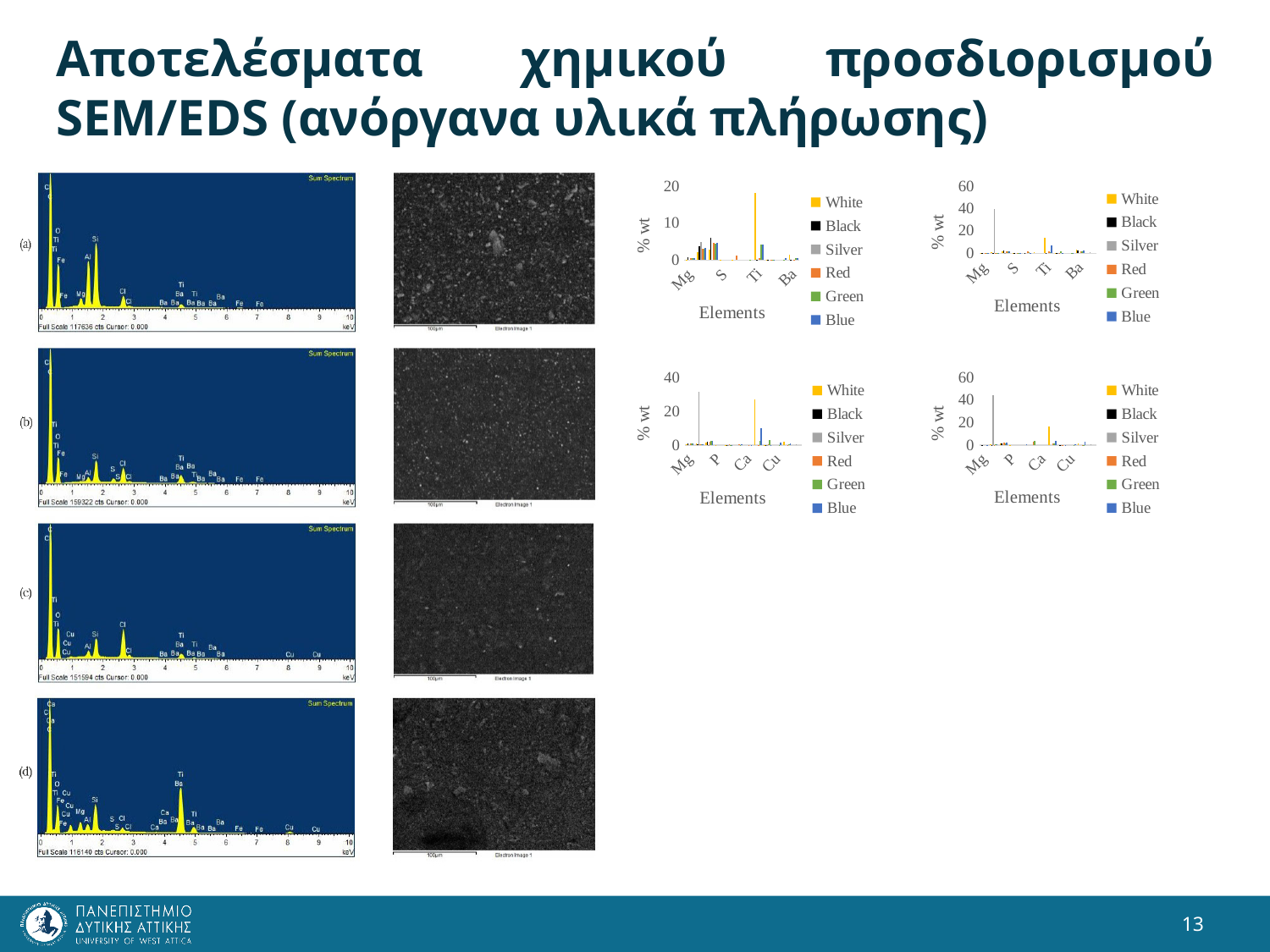
In the top-left bar chart (y-axis up to 20), is the tallest bar, at Ti, greater or less than 10? greater In the bottom-left bar chart (y-axis up to 40), which series has the tallest bar? Silver In the top-left bar chart (y-axis up to 20), which series has the tallest bar? White How many series does the legend of the top-left bar chart (y-axis up to 20) list? 6 What is the y-axis title of the bottom-left bar chart (y-axis up to 40)? % wt What kind of chart is the top-right chart with the y-axis up to 60? bar chart How many series does the legend of the bottom-right bar chart (y-axis up to 60) list? 6 In the bottom-right bar chart (y-axis up to 60), which series has the tallest bar? Silver What is the x-axis title of the bottom-right bar chart (y-axis up to 60)? Elements